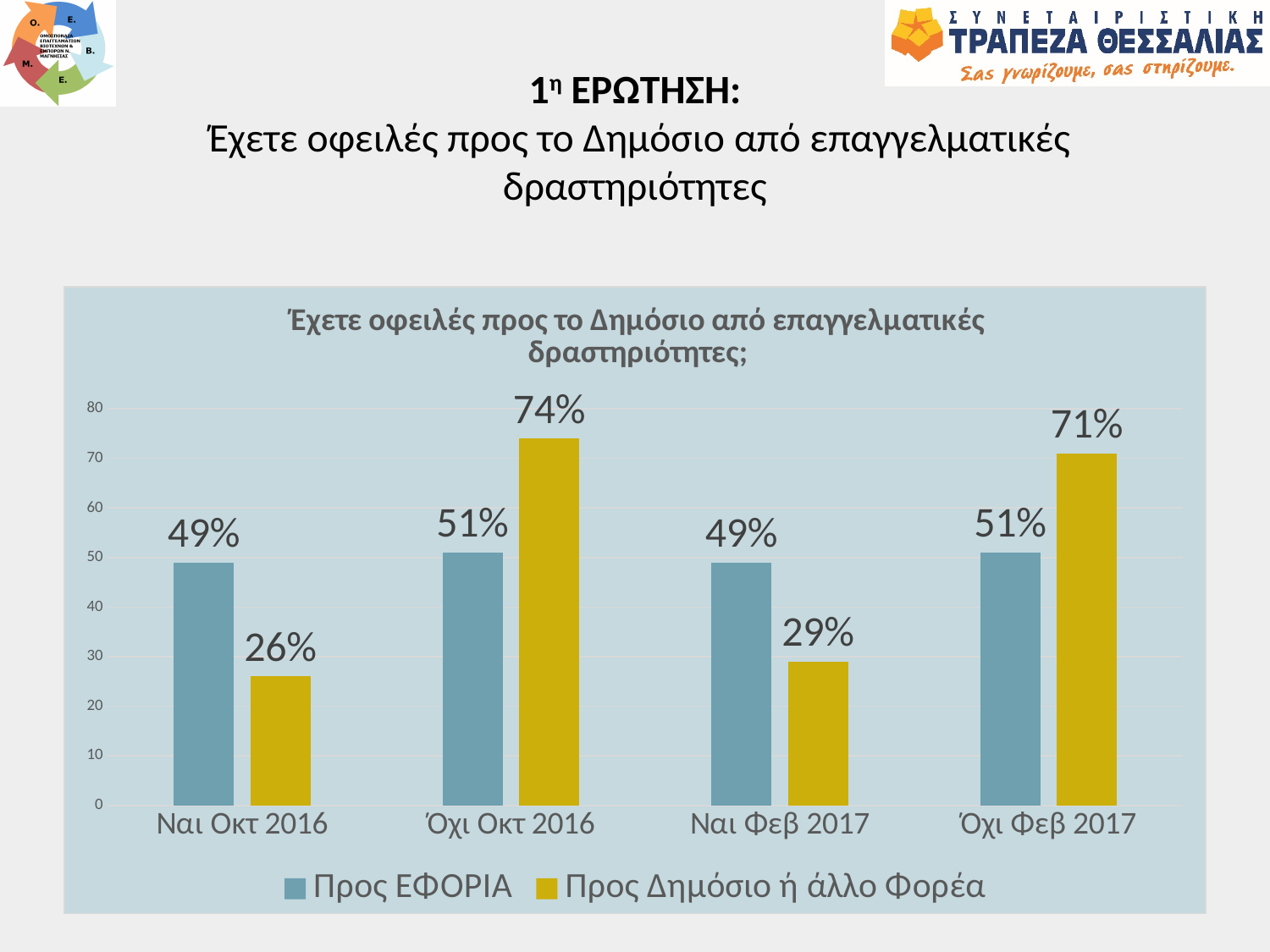
Which category has the highest value for Προς Δημόσιο ή άλλο Φορέα? Όχι Οκτ 2016 What is the value for Προς ΕΦΟΡΙΑ in the Όχι Φεβ 2017 category? 51% What is the value for Προς ΕΦΟΡΙΑ in the Ναι Οκτ 2016 category? 49% Which category has the lowest value for Προς Δημόσιο ή άλλο Φορέα? Ναι Οκτ 2016 How many series does the legend list? 2 In the Ναι Φεβ 2017 category, which series has the larger value, Προς ΕΦΟΡΙΑ or Προς Δημόσιο ή άλλο Φορέα? Προς ΕΦΟΡΙΑ What is the value for Προς Δημόσιο ή άλλο Φορέα in the Ναι Φεβ 2017 category? 29% What is the difference between the Προς Δημόσιο ή άλλο Φορέα values for Όχι Οκτ 2016 and Όχι Φεβ 2017? 3% How many categories are shown on the x axis? 4 What is the value for Προς Δημόσιο ή άλλο Φορέα in the Όχι Οκτ 2016 category? 74% What kind of chart is shown on the slide? Bar chart Which colour represents the Προς Δημόσιο ή άλλο Φορέα series? Yellow